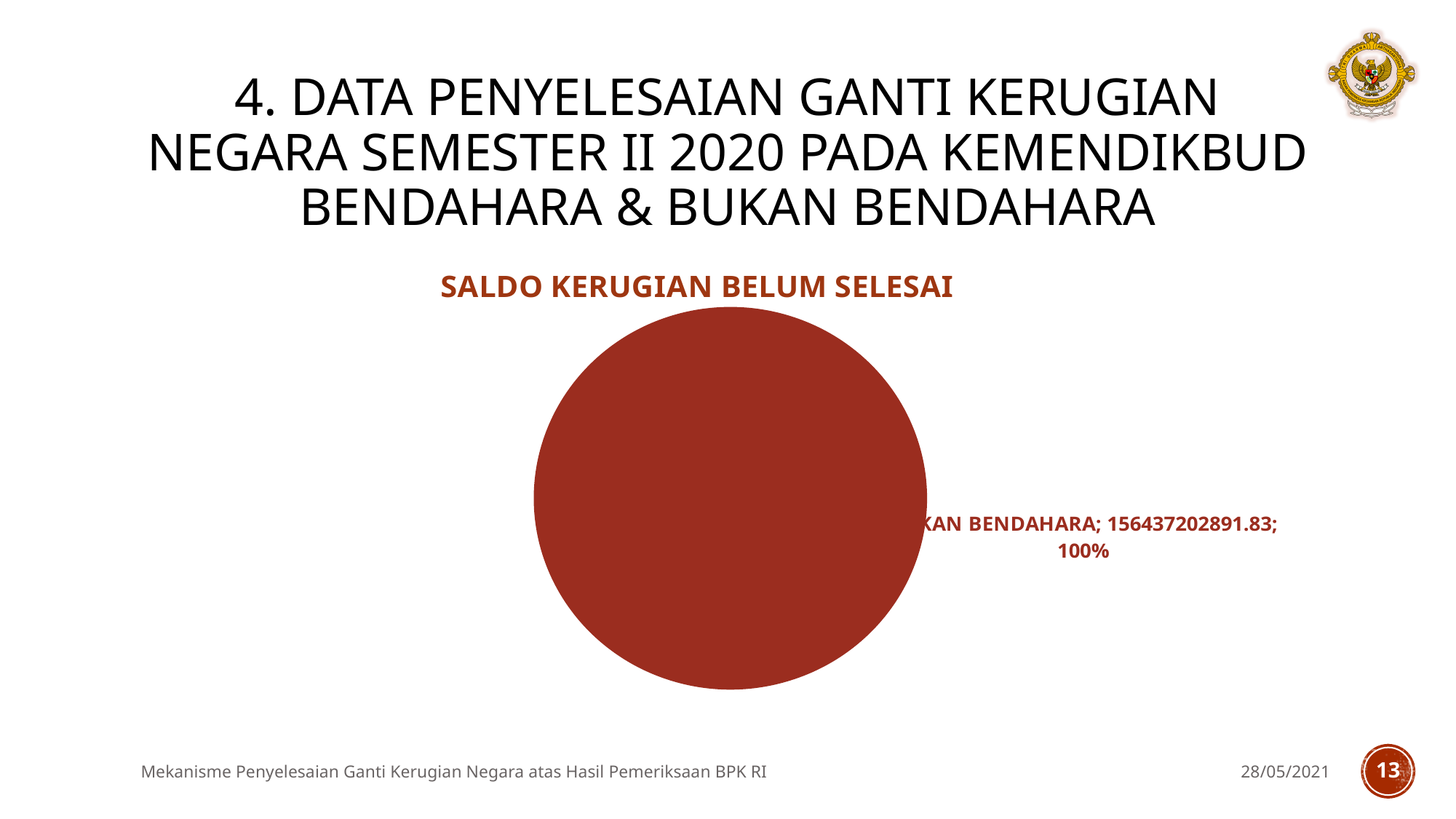
What percentage is printed in the data label of the pie chart? 100% What share of the pie does the single slice represent? 100% What colour is the slice of the pie chart? dark red How many slices does the pie chart contain? 1 Is the value shown in the pie chart's data label greater or less than 100000000000? greater What is the title of the chart on the slide? SALDO KERUGIAN BELUM SELESAI What kind of chart is shown on the slide? pie chart What value is printed in the data label of the pie chart's slice? 156437202891.83